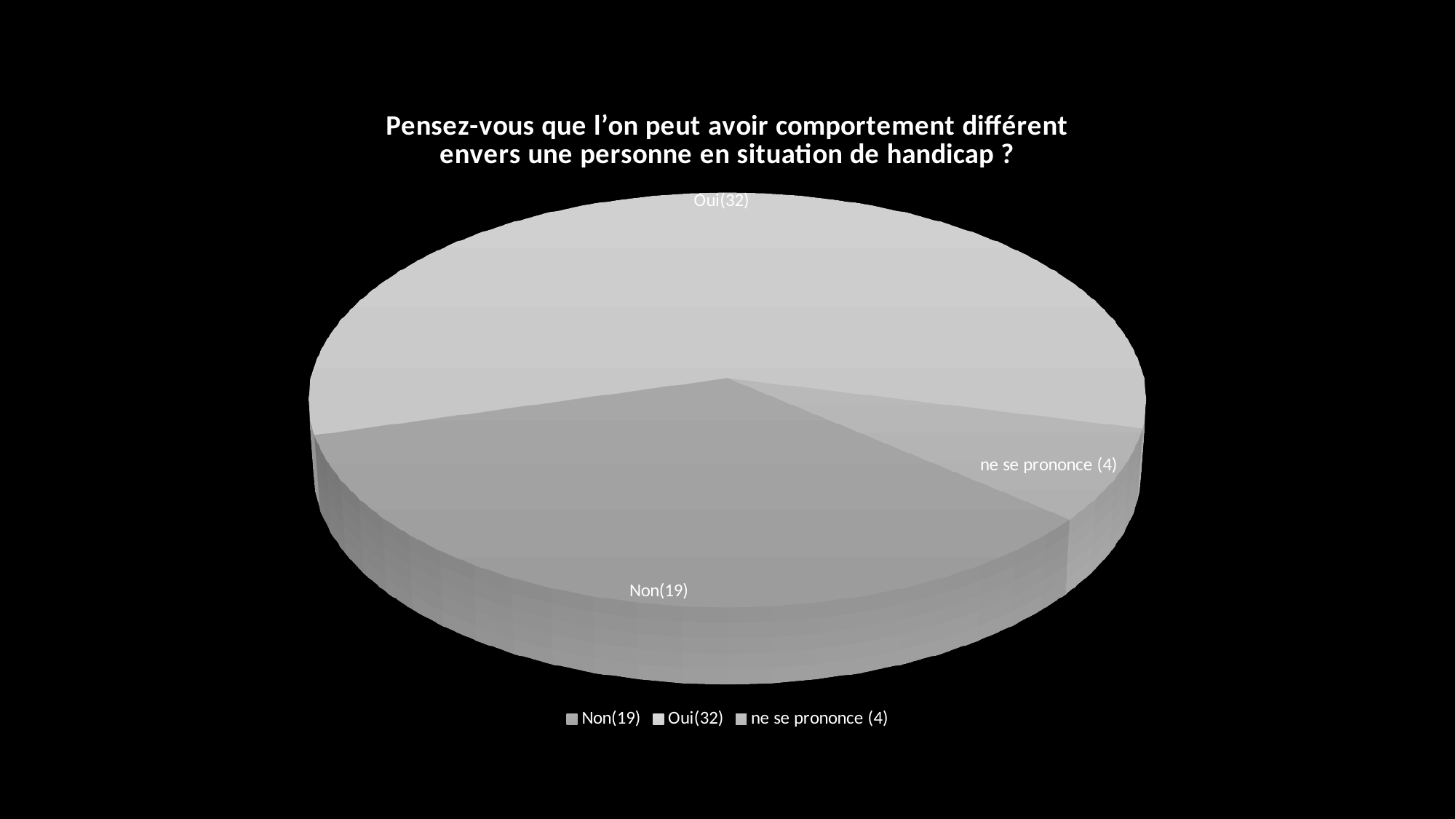
What is the value for Non? 19 Which is larger, the value for Non or the value for 'ne se prononce'? Non What is the value for Oui? 32 What kind of chart is shown on the slide? pie chart What is the title of the chart? Pensez-vous que l'on peut avoir comportement différent envers une personne en situation de handicap ? Which category has the smallest slice? ne se prononce How many slices does the pie chart have? 3 What is the value for 'ne se prononce'? 4 How many entries does the legend list? 3 What is the total of all three slices? 55 Which category has the largest slice? Oui What is the difference between the values for Oui and Non? 13